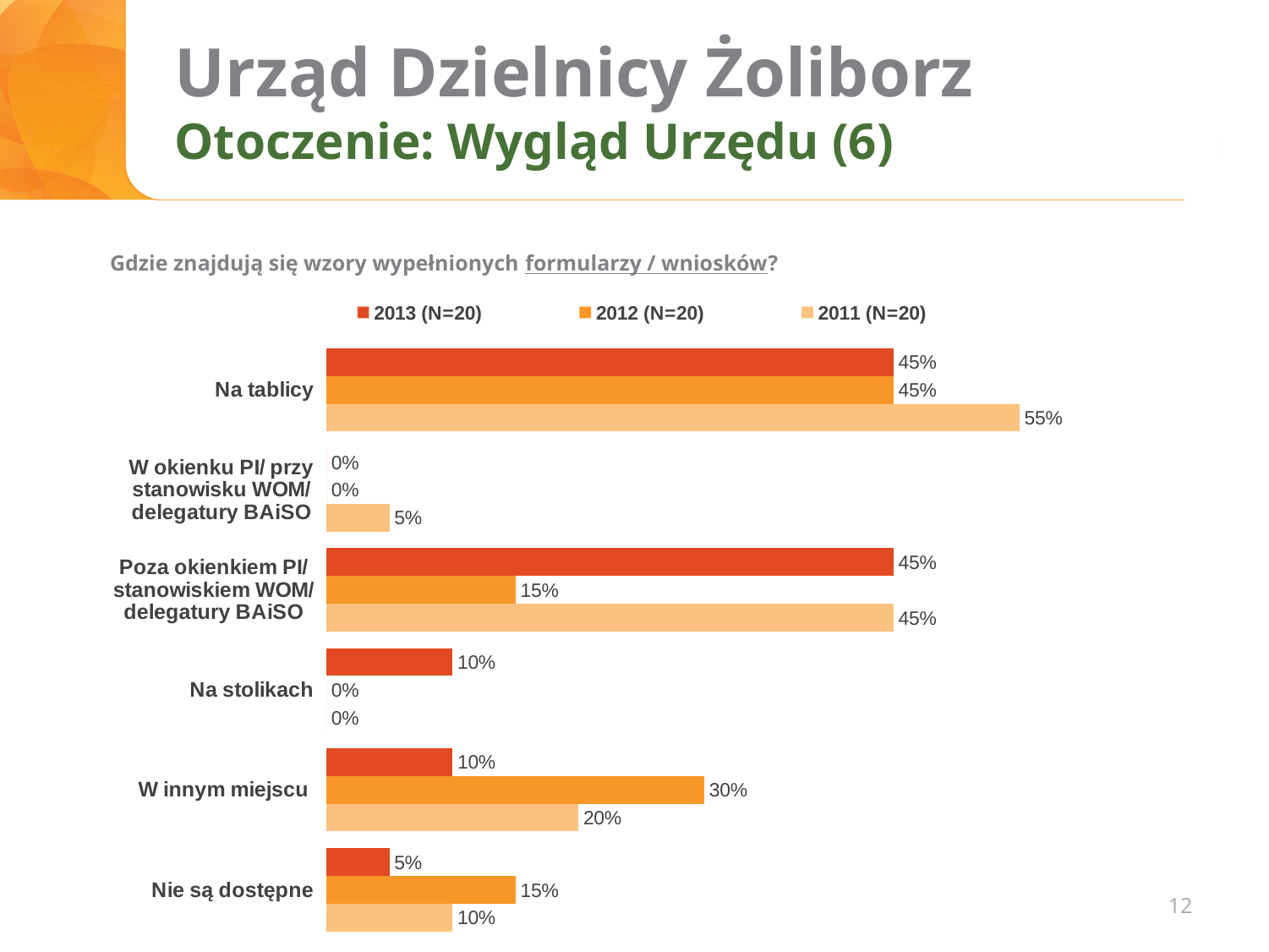
What is the difference between the 2013 (N=20) and 2012 (N=20) values for "Poza okienkiem PI/ stanowiskiem WOM/ delegatury BAiSO"? 30% How many categories are shown on the chart? 6 What question does the chart answer, as written above it? Gdzie znajdują się wzory wypełnionych formularzy / wniosków? Which category has the lowest value in the 2013 (N=20) series? W okienku PI/ przy stanowisku WOM/ delegatury BAiSO Which category has the highest value in the 2011 (N=20) series? Na tablicy Which is larger for "W innym miejscu": the 2012 (N=20) value or the 2011 (N=20) value? 2012 (N=20) What is the value for "Nie są dostępne" in the 2013 (N=20) series? 5% What is the value for "Na tablicy" in the 2011 (N=20) series? 55% What is the difference between the 2011 (N=20) and 2013 (N=20) values for "Na tablicy"? 10% What kind of chart is shown on the slide? Bar chart How many series does the legend list? 3 What is the value for "W innym miejscu" in the 2012 (N=20) series? 30%